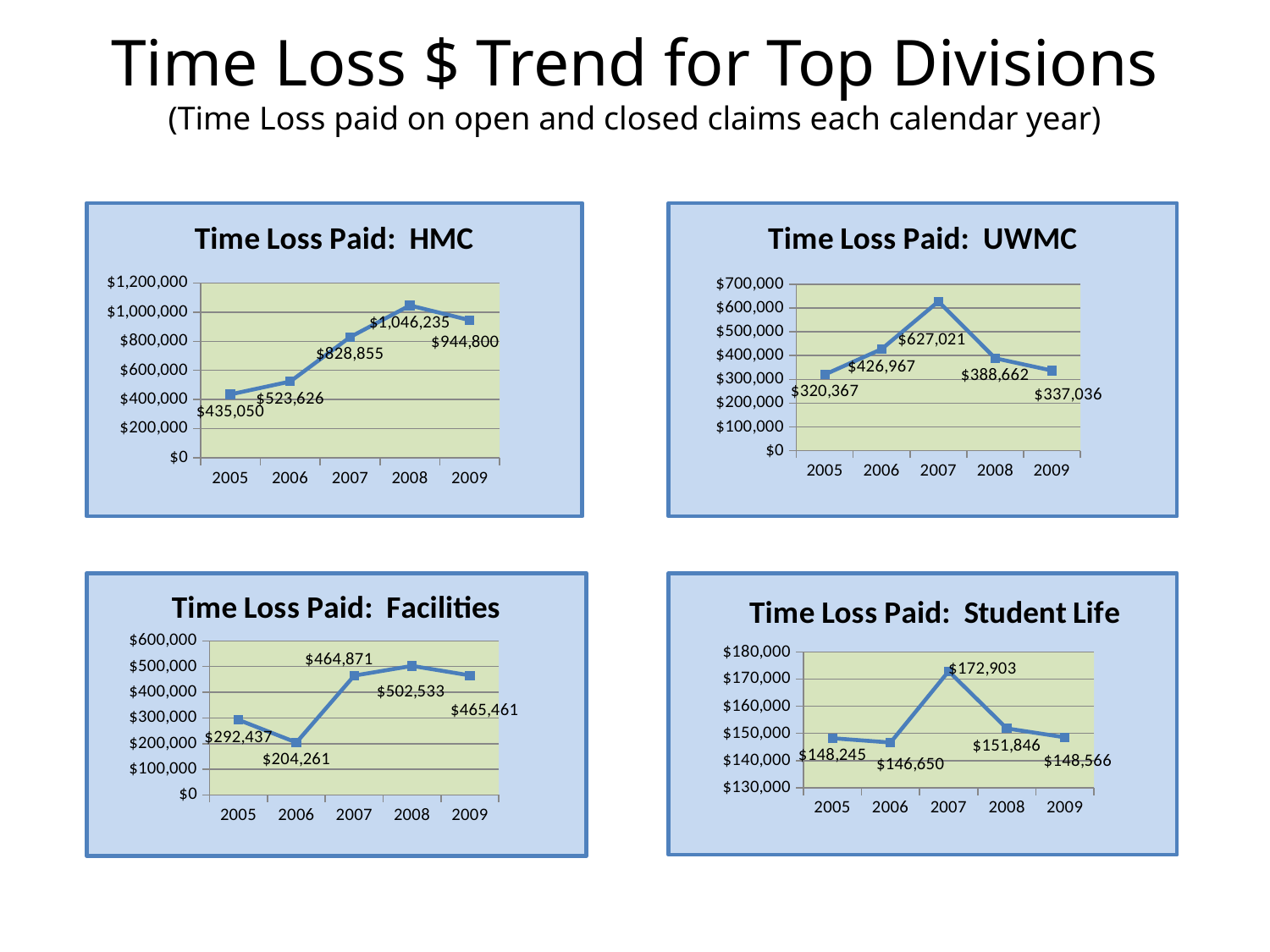
In the 'Time Loss Paid: UWMC' chart, what was the time loss paid in 2005? $320,367 In the 'Time Loss Paid: HMC' chart, what was the time loss paid in 2008? $1,046,235 How many years are plotted in the 'Time Loss Paid: HMC' chart? 5 In the 'Time Loss Paid: UWMC' chart, how much higher was the 2007 value than the 2006 value? $200,054 In the 'Time Loss Paid: HMC' chart, did the time loss paid rise or fall from 2005 to 2008? Rise In the 'Time Loss Paid: Student Life' chart, which is larger, the value for 2005 or the value for 2006? 2005 In the 'Time Loss Paid: UWMC' chart, which year had the highest time loss paid? 2007 In the 'Time Loss Paid: Facilities' chart, what was the time loss paid in 2006? $204,261 In the 'Time Loss Paid: Facilities' chart, which year had the lowest time loss paid? 2006 In the 'Time Loss Paid: HMC' chart, how much did time loss paid decrease from 2008 to 2009? $101,435 In the 'Time Loss Paid: Student Life' chart, what was the time loss paid in 2009? $148,566 What type of chart is 'Time Loss Paid: Facilities'? Line chart